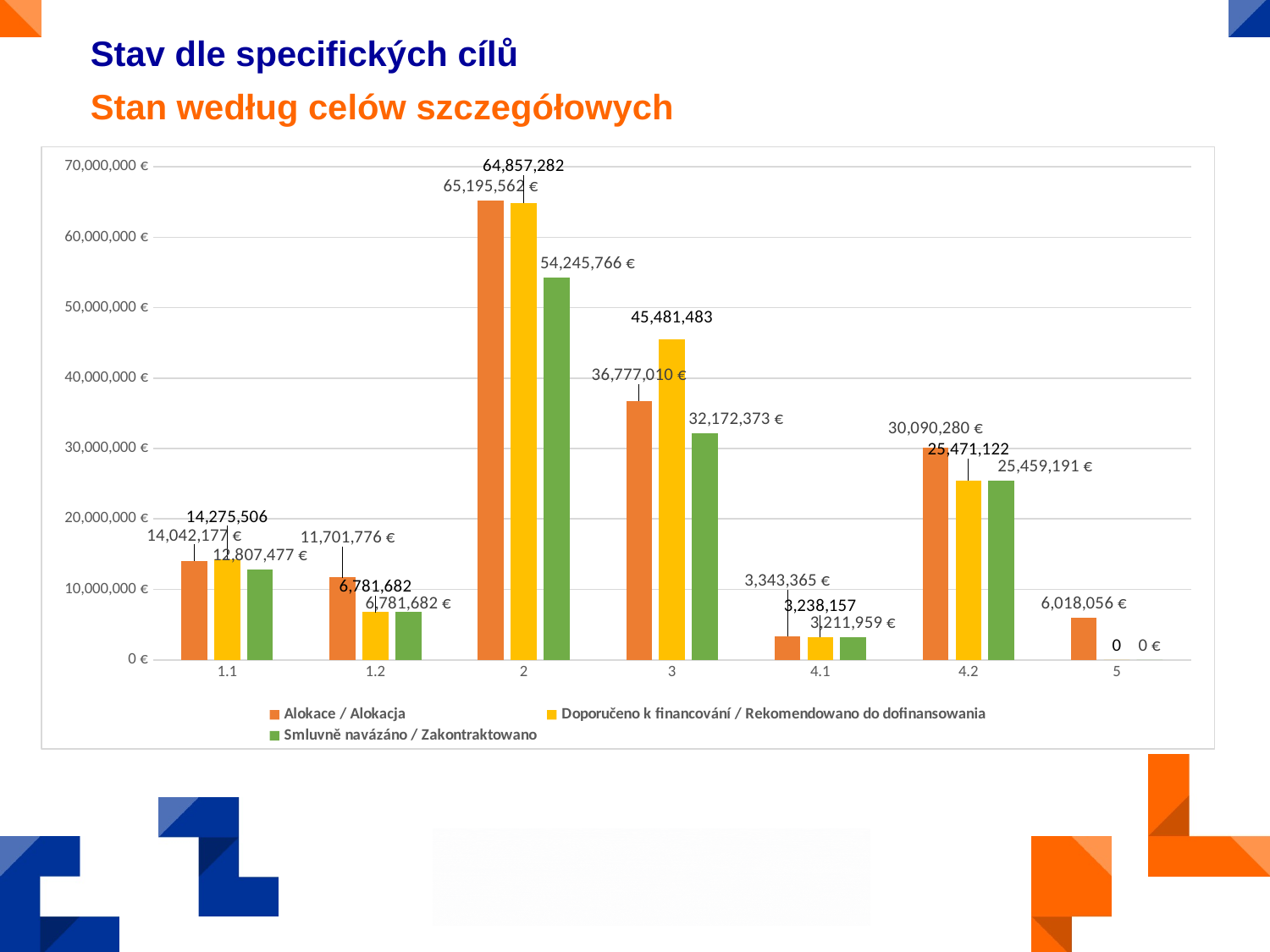
How many series does the legend list? 3 What is the Doporučeno k financování / Rekomendowano do dofinansowania value for category 4.2? 25,471,122 What is the Smluvně navázáno / Zakontraktowano value for category 3? 32,172,373 € Which category has the highest Alokace / Alokacja value? 2 What is the difference between the Alokace / Alokacja value and the Smluvně navázáno / Zakontraktowano value for category 2? 10,949,796 € What type of chart is shown on the slide? bar chart For category 3, which is larger: the Alokace / Alokacja value or the Doporučeno k financování / Rekomendowano do dofinansowania value? Doporučeno k financování / Rekomendowano do dofinansowania How many categories are shown on the x axis? 7 Is the Alokace / Alokacja value for category 4.2 greater or less than 30,000,000 €? greater What colour are the bars for the Smluvně navázáno / Zakontraktowano series? green Which category has the lowest Smluvně navázáno / Zakontraktowano value? 5 What is the Alokace / Alokacja value for category 2? 65,195,562 €